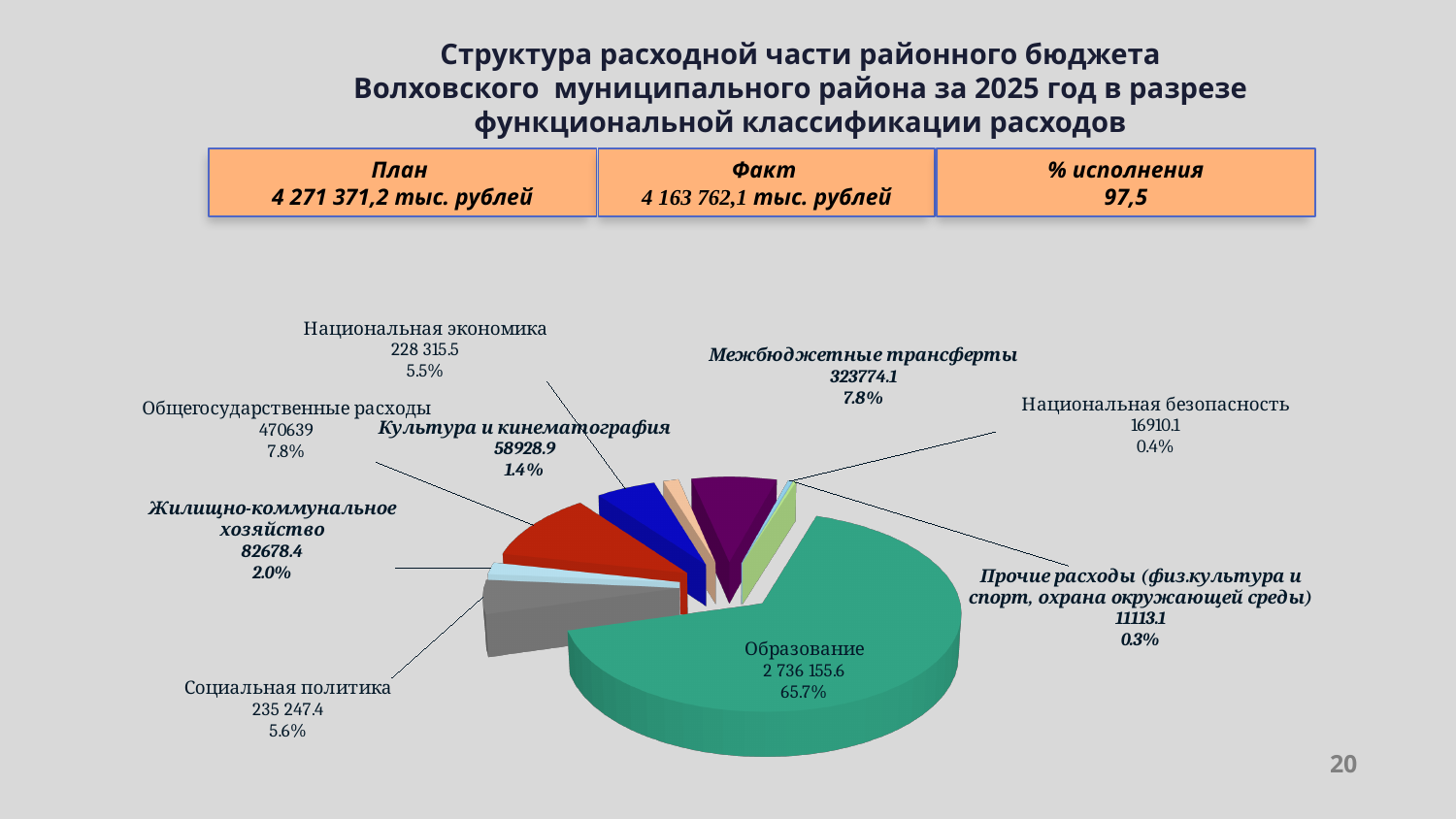
What percentage is shown for Межбюджетные трансферты? 7.8% Which is larger: the value for Национальная экономика or the value for Жилищно-коммунальное хозяйство? Национальная экономика What percentage is shown for Национальная безопасность? 0.4% How many categories (slices) does the pie chart show? 9 Which category has the largest slice of the pie? Образование What is the value shown for Образование? 2 736 155.6 What is the value shown for Культура и кинематография? 58928.9 What is the difference in percentage points between the shares of Социальная политика and Национальная экономика? 0.1% What is the value shown for Социальная политика? 235 247.4 What share of the pie does Образование account for? 65.7% What kind of chart is shown on the slide? Pie chart Which category has the smallest share of the pie? Прочие расходы (физ.культура и спорт, охрана окружающей среды)